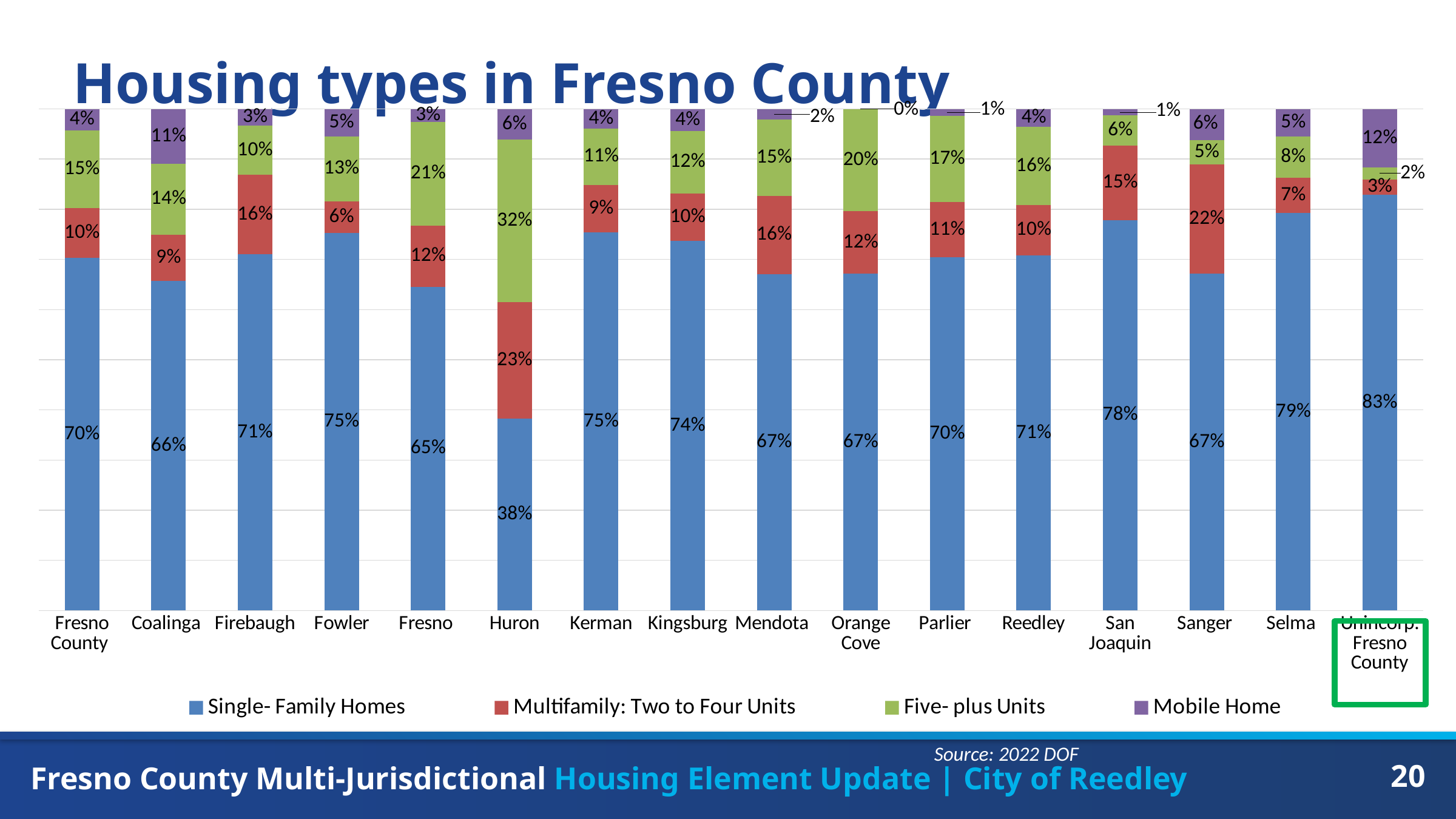
What is the difference between the Single- Family Homes share in Selma and in Huron? 41% What is the Mobile Home share for Coalinga? 11% Which category has the lowest Single- Family Homes share? Huron What is the title of the chart? Housing types in Fresno County Which has a larger Five- plus Units share, Orange Cove or Reedley? Orange Cove What is the Multifamily: Two to Four Units share for Sanger? 22% What share of housing in Huron is Single- Family Homes? 38% What is the Five- plus Units share for Fresno? 21% How many categories are shown on the x axis? 16 How many series does the legend list? 4 Which category has the highest Single- Family Homes share? Unincorp. Fresno County What kind of chart is shown on the slide? Stacked bar chart